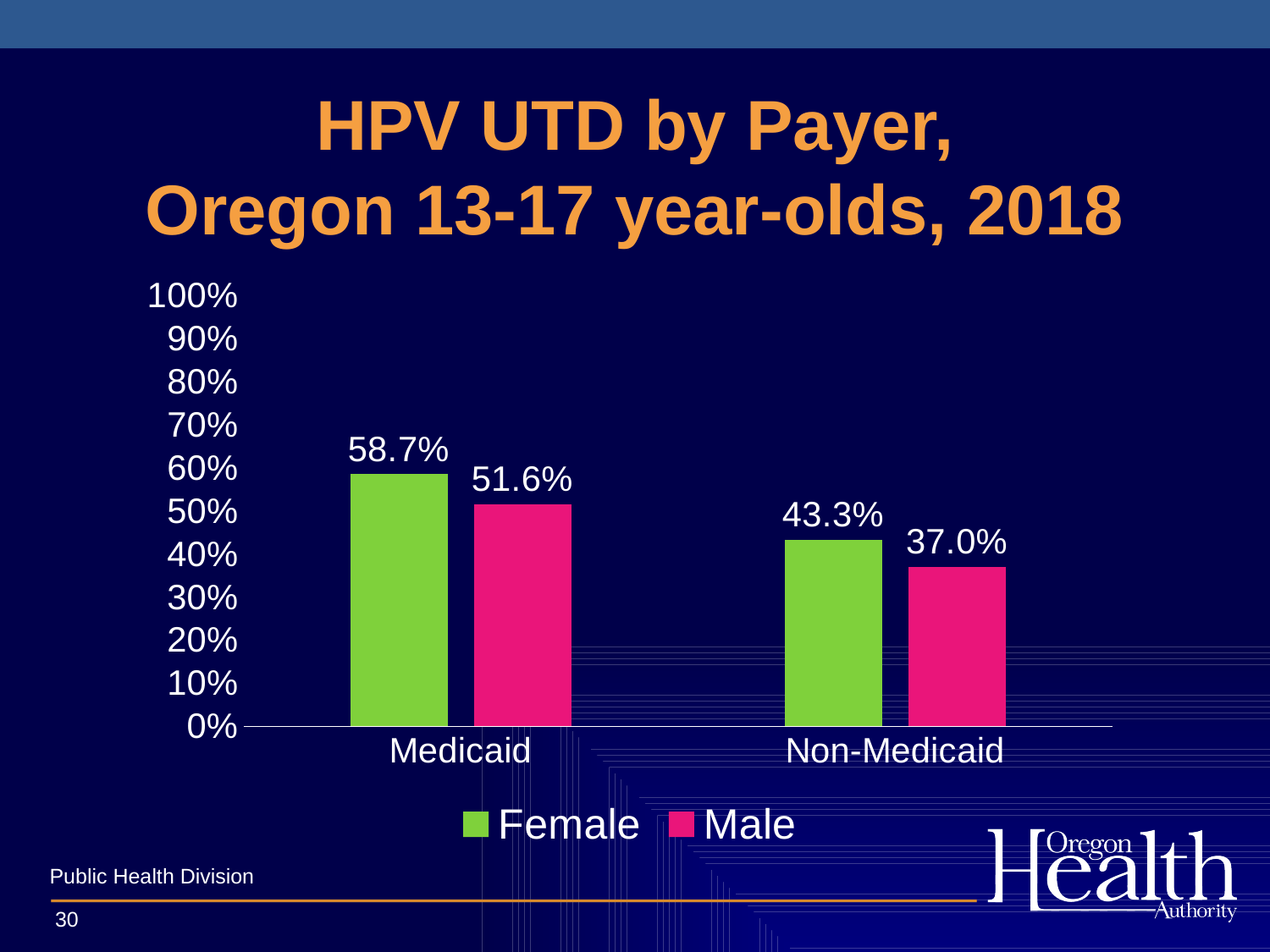
What is the difference between the Female and Male HPV UTD rates in the Medicaid group? 7.1% Which payer group and sex has the lowest HPV UTD rate? Male Non-Medicaid Is the Female HPV UTD rate higher for Medicaid or Non-Medicaid? Medicaid What is the HPV UTD rate for Female Medicaid 13-17 year-olds? 58.7% What is the difference between the Female Medicaid and Female Non-Medicaid HPV UTD rates? 15.4% Is the Female Non-Medicaid HPV UTD rate greater or less than 50%? less How many series does the legend list? 2 How many payer categories are shown on the x axis? 2 What is the HPV UTD rate for Male Non-Medicaid 13-17 year-olds? 37.0% Which payer group and sex has the highest HPV UTD rate? Female Medicaid What kind of chart is shown on the slide? Bar chart What is the HPV UTD rate for Male Medicaid 13-17 year-olds? 51.6%